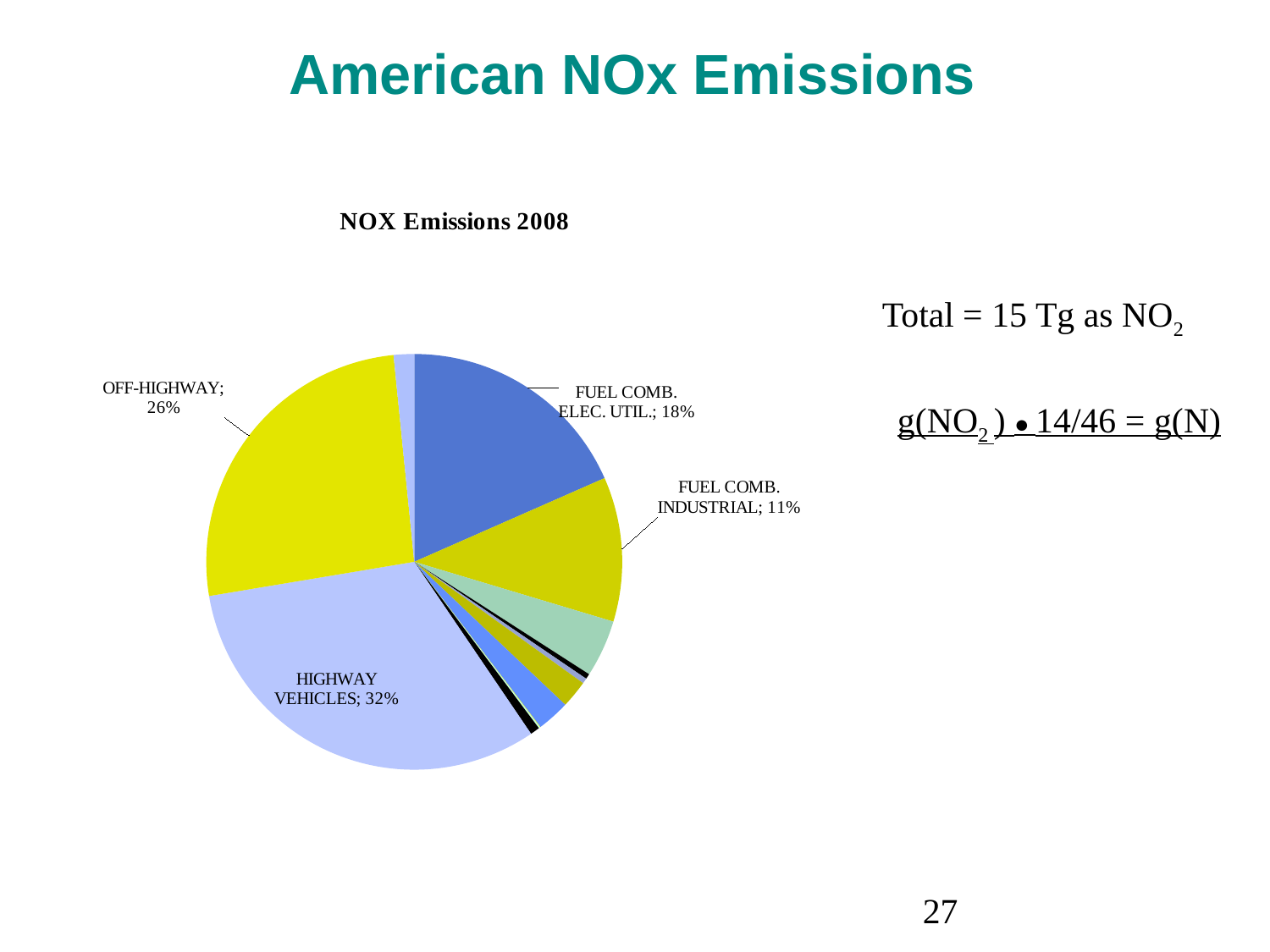
Of the four labeled slices, which has the smallest share? FUEL COMB. INDUSTRIAL How many percentage points larger is HIGHWAY VEHICLES than OFF-HIGHWAY? 6 Which category has the largest slice of the pie? HIGHWAY VEHICLES Which is larger, the share for OFF-HIGHWAY or the share for FUEL COMB. ELEC. UTIL.? OFF-HIGHWAY What percentage is shown for FUEL COMB. INDUSTRIAL? 11% What type of chart is shown on the slide? Pie chart What is the difference in percentage points between FUEL COMB. ELEC. UTIL. and FUEL COMB. INDUSTRIAL? 7 What is the combined share of HIGHWAY VEHICLES and OFF-HIGHWAY? 58% What percentage is shown for FUEL COMB. ELEC. UTIL.? 18% What share of the pie does HIGHWAY VEHICLES account for? 32% What percentage is shown for OFF-HIGHWAY? 26% What is the title of the chart? NOX Emissions 2008